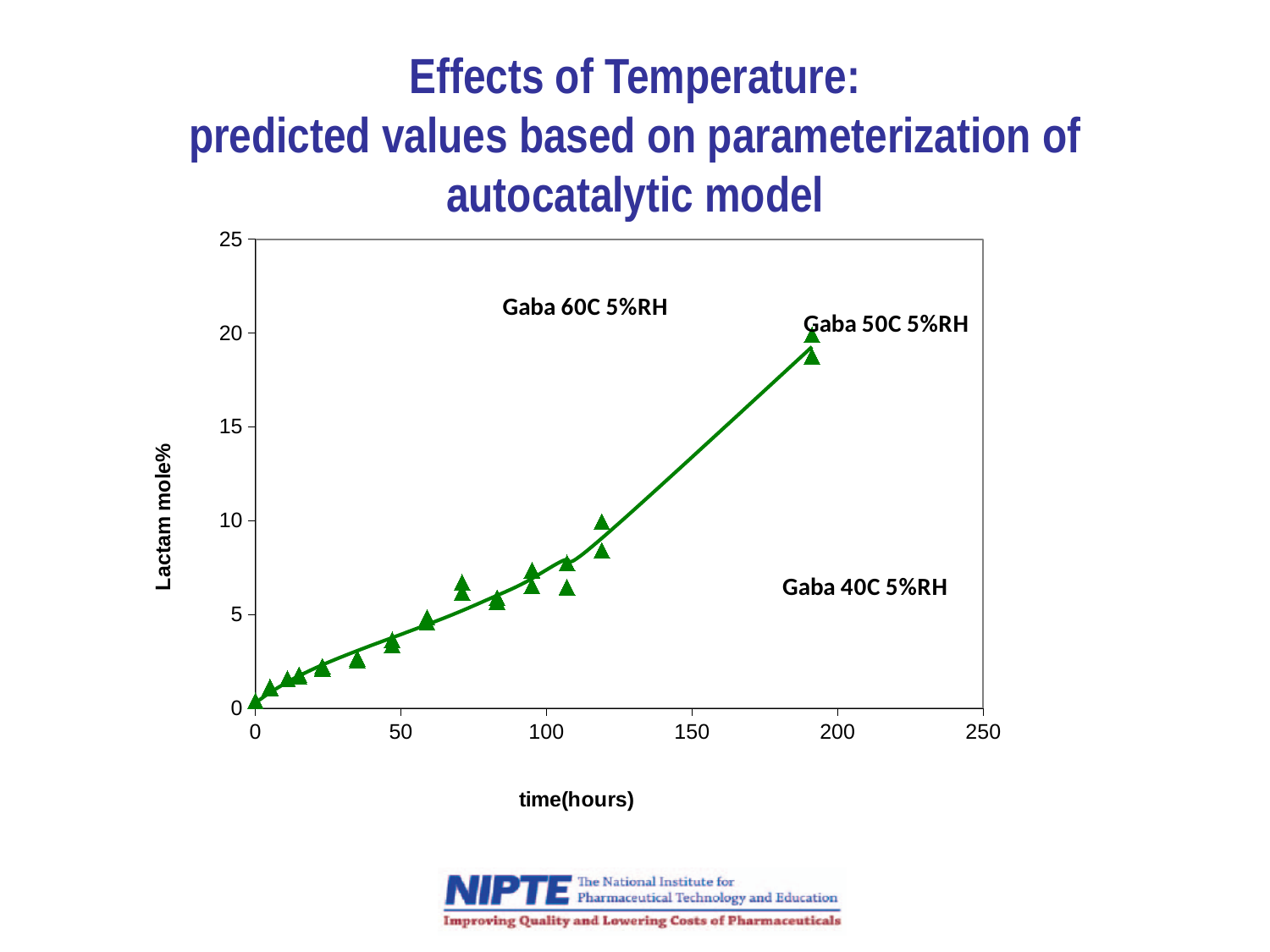
What is the highest tick value shown on the x axis? 250 Do the plotted Lactam mole% values rise or fall as time increases? rise What is the label of the y axis? Lactam mole% Is the Lactam mole% value at about 190 hours greater or less than 15? greater What kind of chart is shown on the slide? scatter plot with a fitted line Is the Lactam mole% value at about 120 hours greater or less than 15? less Is the Lactam mole% value at about 50 hours greater or less than 5? less What is the label of the x axis? time(hours)